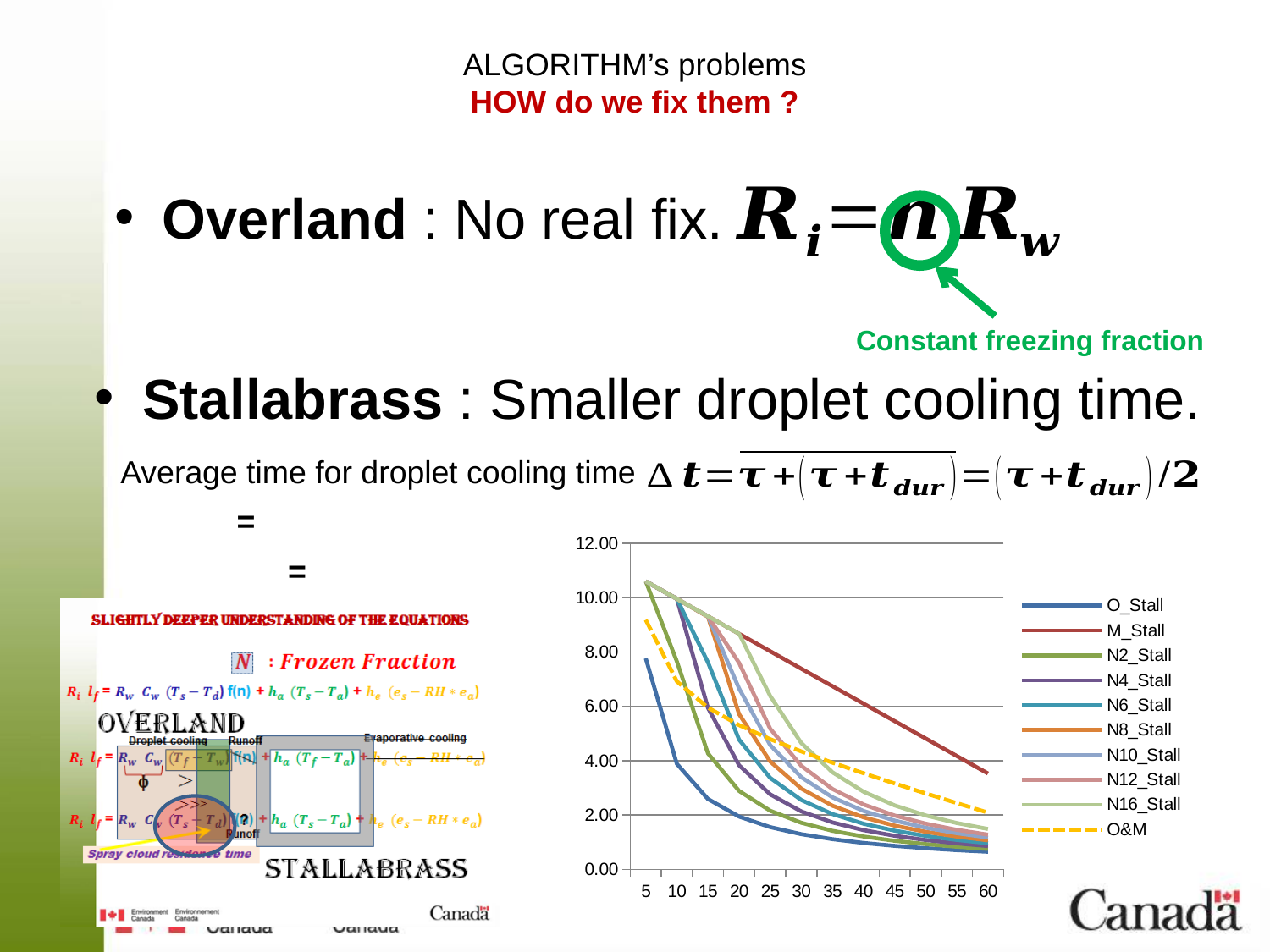
Which legend entry is drawn with a dashed line? O&M Is the value of O_Stall at x = 5 greater or less than 6.00? greater How many x-axis tick values are shown on the chart? 12 Do the values of the M_Stall series rise or fall as the x-axis value increases? fall Is the value of O&M at x = 5 greater or less than 8.00? greater How many series does the chart's legend list? 10 Is the value of M_Stall at x = 60 greater or less than 2.00? greater At x = 5, which is larger: the value of O&M or the value of O_Stall? O&M Which series has the highest value at x = 60? M_Stall What kind of chart is shown on the slide? line chart Which series has the lowest value at x = 5? O_Stall